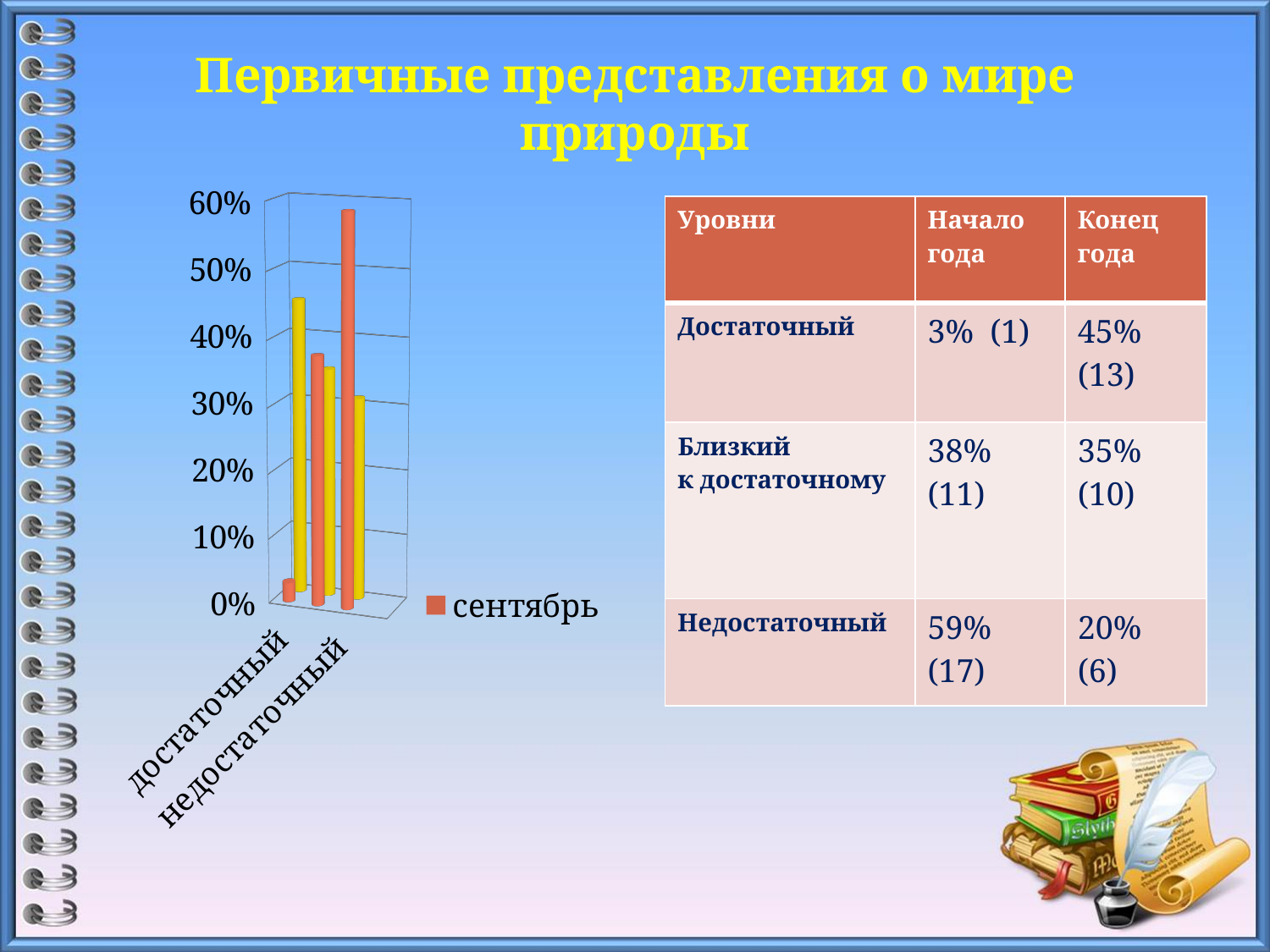
What is the highest tick value shown on the chart's vertical axis? 60% For достаточный, which bar is taller: the orange сентябрь bar or the yellow bar? the yellow bar For недостаточный, which bar is taller: the orange сентябрь bar or the yellow bar? the orange сентябрь bar How many series does the chart legend list? 1 Which labelled category has the shortest сентябрь bar? достаточный Is the yellow bar for недостаточный greater or less than 40%? less What kind of chart is shown on the left of the slide? bar chart Is the yellow bar for достаточный greater or less than 40%? greater Is the сентябрь value for недостаточный greater or less than 50%? greater Which labelled category has the tallest сентябрь bar? недостаточный What is the name of the series shown in the chart legend? сентябрь